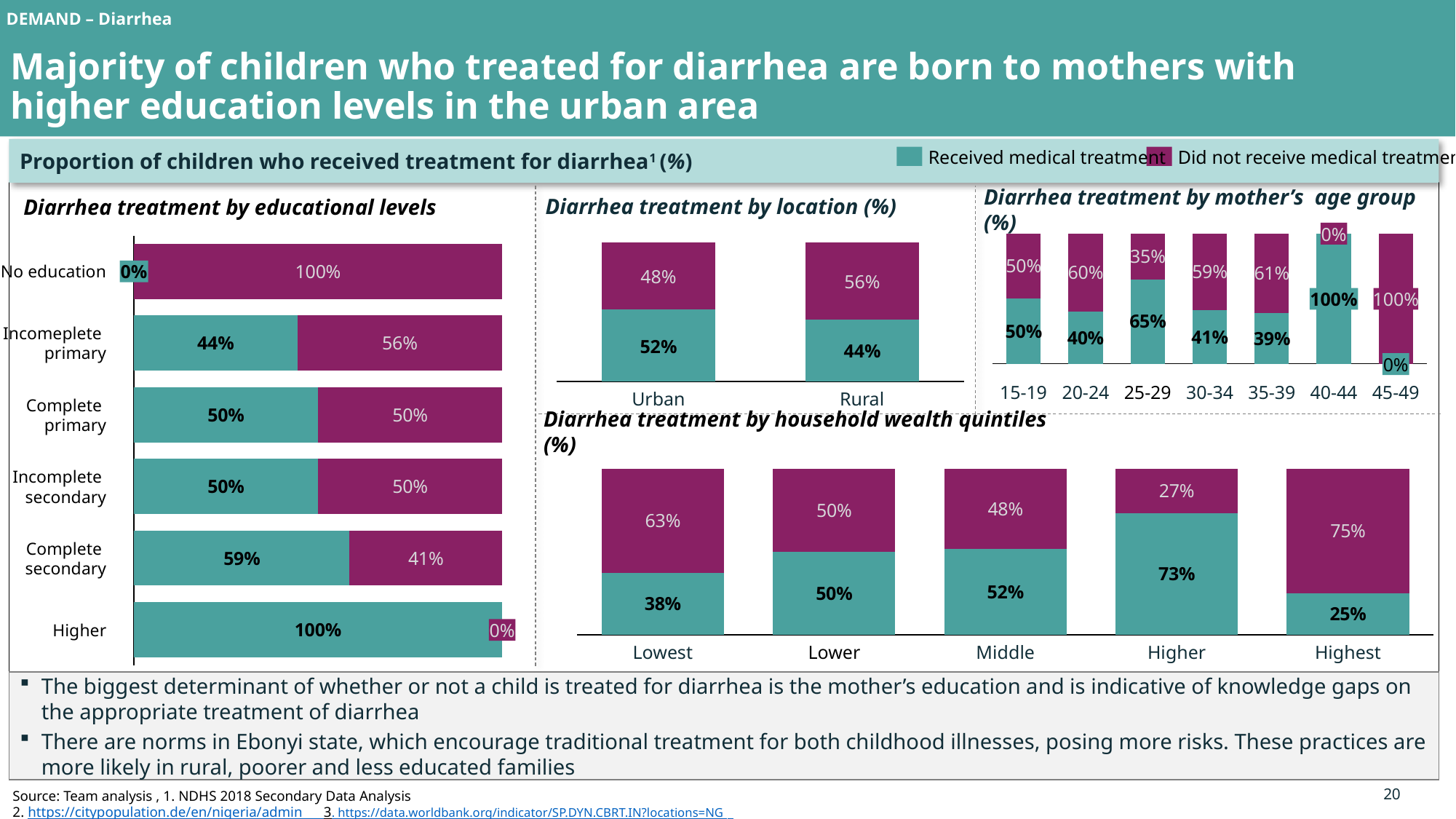
In the 'Diarrhea treatment by location (%)' chart, what percentage of children in urban areas received medical treatment? 52% In the 'Diarrhea treatment by mother's age group (%)' chart, what percentage of children of mothers aged 25-29 received medical treatment? 65% In the 'Diarrhea treatment by mother's age group (%)' chart, how many age groups are shown? 7 In the 'Diarrhea treatment by mother's age group (%)' chart, which is larger: the received-treatment share for 20-24 or for 35-39? 20-24 In the 'Diarrhea treatment by household wealth quintiles (%)' chart, which wealth quintile has the highest share of children who received medical treatment? Higher In the 'Diarrhea treatment by educational levels' chart, what is the difference between the received-treatment shares for complete secondary and incomplete primary? 15% How many series does the legend at the top of the slide list? 2 In the 'Diarrhea treatment by educational levels' chart, what percentage of children of mothers with complete secondary education received medical treatment? 59% In the 'Diarrhea treatment by household wealth quintiles (%)' chart, which wealth quintile has the lowest share of children who received medical treatment? Highest In the 'Diarrhea treatment by household wealth quintiles (%)' chart, what percentage of children in the Lowest quintile did not receive medical treatment? 63% In the 'Diarrhea treatment by location (%)' chart, what percentage of children in rural areas did not receive medical treatment? 56% In the 'Diarrhea treatment by educational levels' chart, which education level has the highest share of children who received medical treatment? Higher